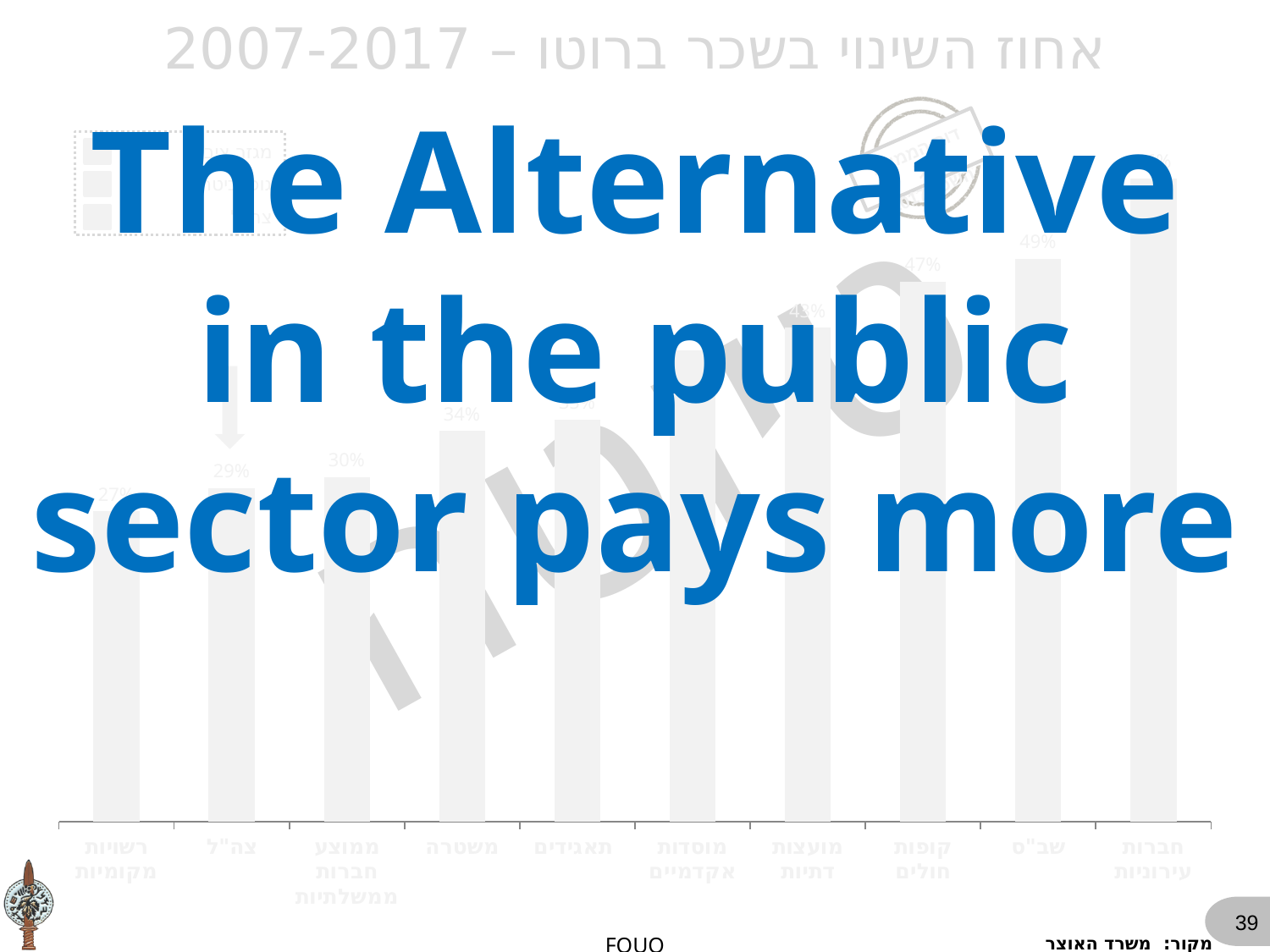
What is the value shown for קופות חולים? 47% What is the value shown for רשויות מקומיות? 27% What is the value shown for שב"ס? 49% How many categories are shown along the x axis of the chart? 10 What is the difference between the values for משטרה and צה"ל? 5 percentage points Which category has the lowest value in the chart? רשויות מקומיות What is the value shown for משטרה? 34% What kind of chart is shown on the slide? bar chart What is the value shown for צה"ל? 29% Which category has the tallest bar in the chart? חברות עירוניות Do the bar values rise or fall from left to right along the x axis? rise What is the value shown for ממוצע חברות ממשלתיות? 30%